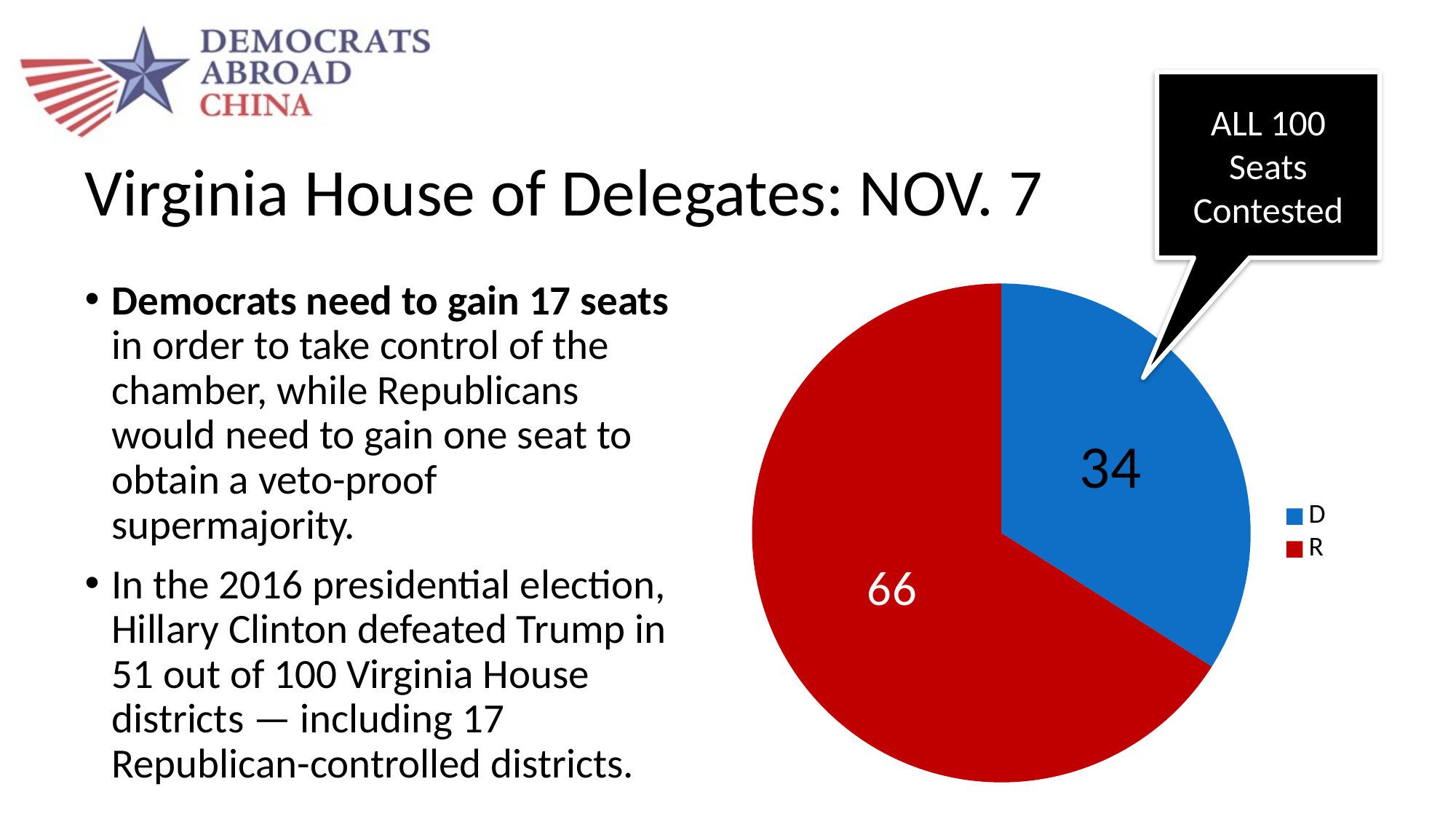
Which is larger in the pie chart, D or R? R How many slices does the pie chart have? 2 How many entries does the legend list? 2 Which category has the smallest slice in the pie chart? D Which category has the largest slice in the pie chart? R What kind of chart is shown on the slide? pie chart What share of the pie does the D slice represent? 34% What is the value for R in the pie chart? 66 What is the difference between the R and D values in the pie chart? 32 What is the value for D in the pie chart? 34 What is the total of the two slices in the pie chart? 100 What colour is the R slice in the pie chart? red